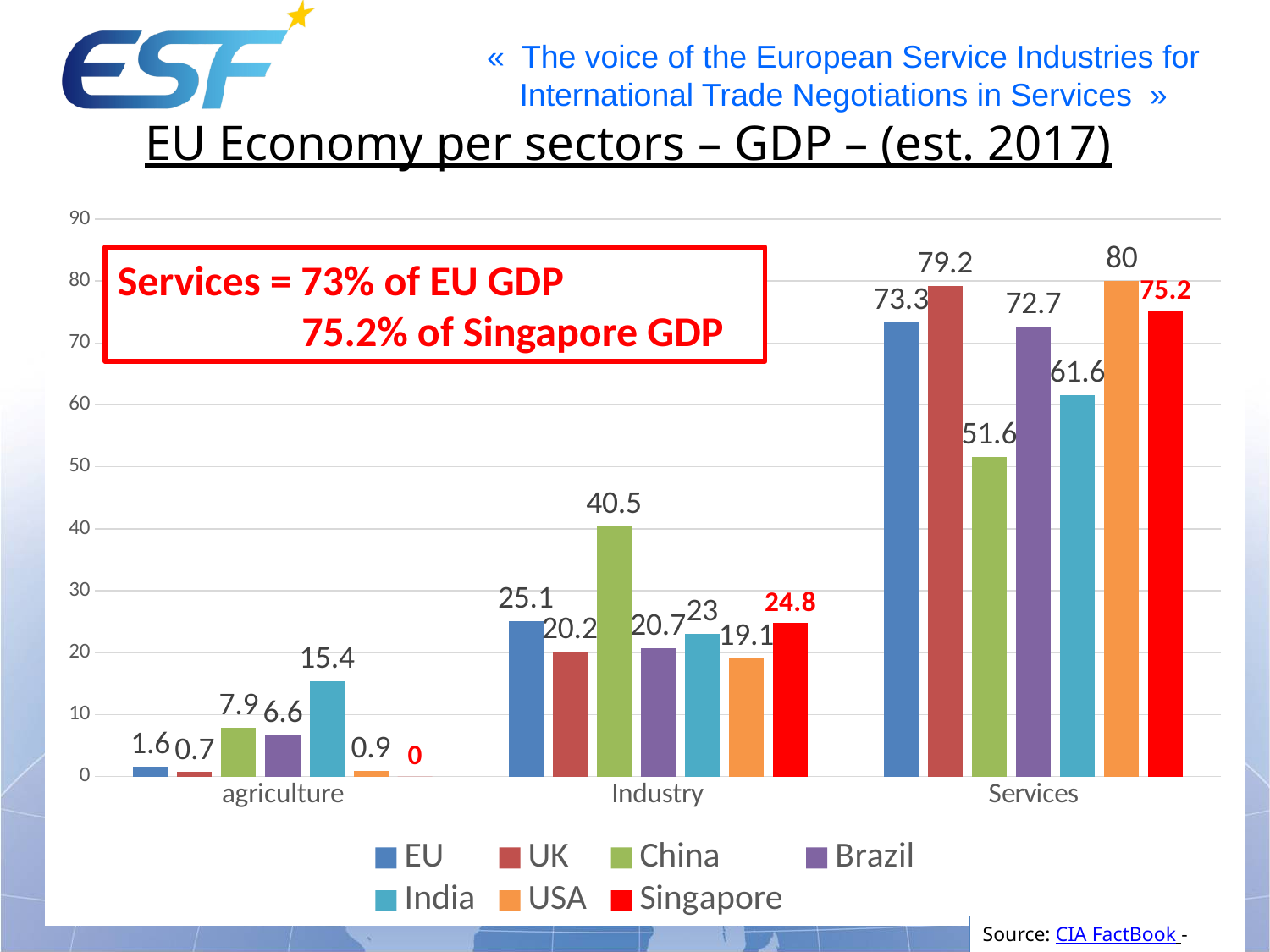
Is the value for China in the Services category greater or less than 60? less What is the value for Singapore in the Services category? 75.2 In the Industry category, which is larger: the value for EU or the value for Singapore? EU What is the value for India in the agriculture category? 15.4 What is the value for China in the Industry category? 40.5 How many sector categories are shown on the x axis? 3 Which country has the lowest value in the agriculture category? Singapore How many series does the legend list? 7 Which country has the highest value in the Services category? USA What kind of chart is shown on the slide? bar chart What is the difference between the UK and EU values in the Services category? 5.9 What is the title of the chart? EU Economy per sectors – GDP – (est. 2017)